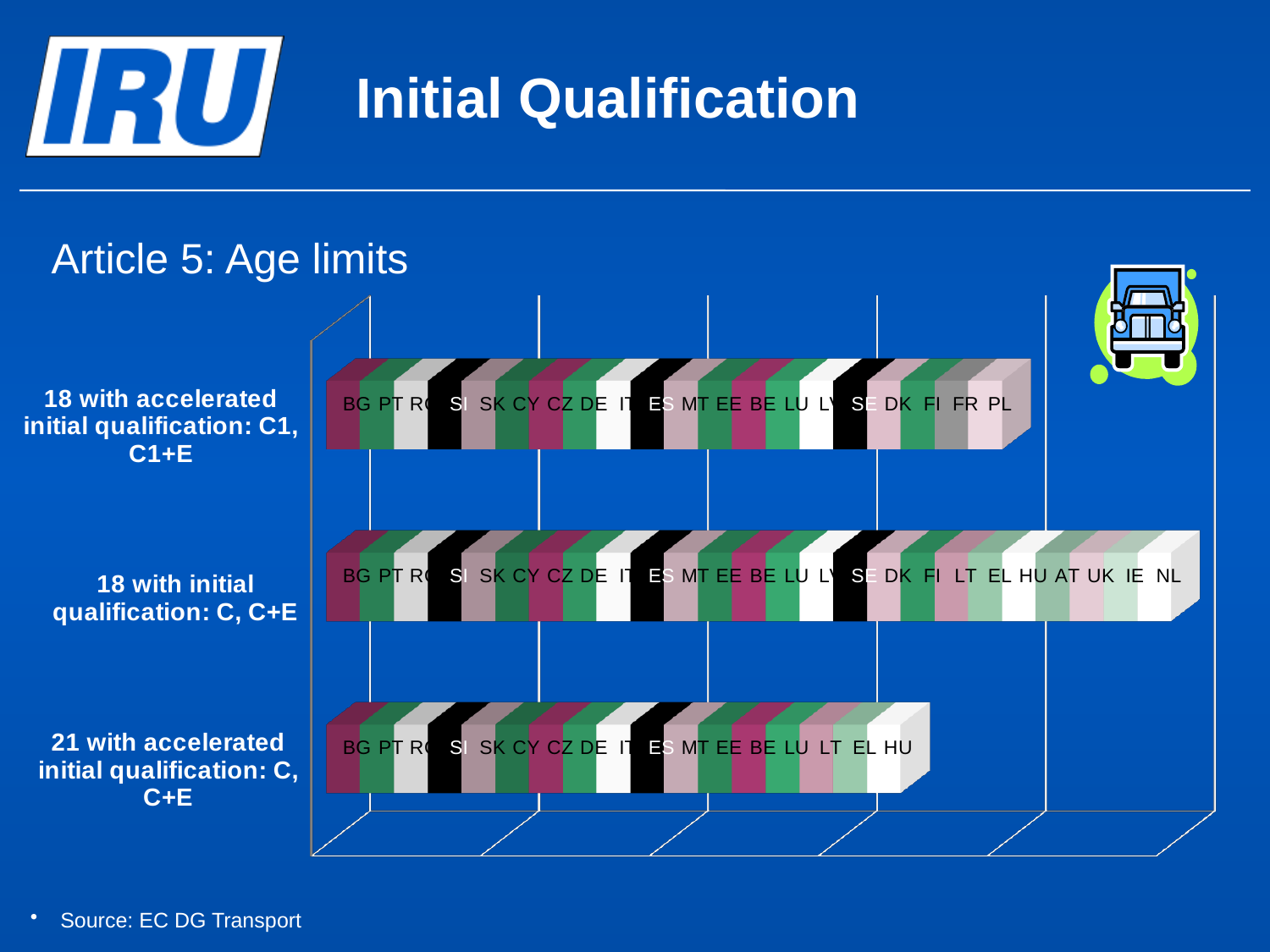
Which bar is longer: '18 with accelerated initial qualification: C1, C1+E' or '21 with accelerated initial qualification: C, C+E'? 18 with accelerated initial qualification: C1, C1+E How many country segments make up the bar for '21 with accelerated initial qualification: C, C+E'? 17 Which category has the longest bar? 18 with initial qualification: C, C+E Which bar is longer: '18 with initial qualification: C, C+E' or '18 with accelerated initial qualification: C1, C1+E'? 18 with initial qualification: C, C+E What kind of chart is shown on the slide? bar chart Which category has the shortest bar? 21 with accelerated initial qualification: C, C+E How many country segments make up the bar for '18 with initial qualification: C, C+E'? 25 How many country segments make up the bar for '18 with accelerated initial qualification: C1, C1+E'? 20 What is the heading above the chart? Article 5: Age limits What source is cited for the chart? EC DG Transport Which country label appears last (rightmost) in the bar for '18 with initial qualification: C, C+E'? NL